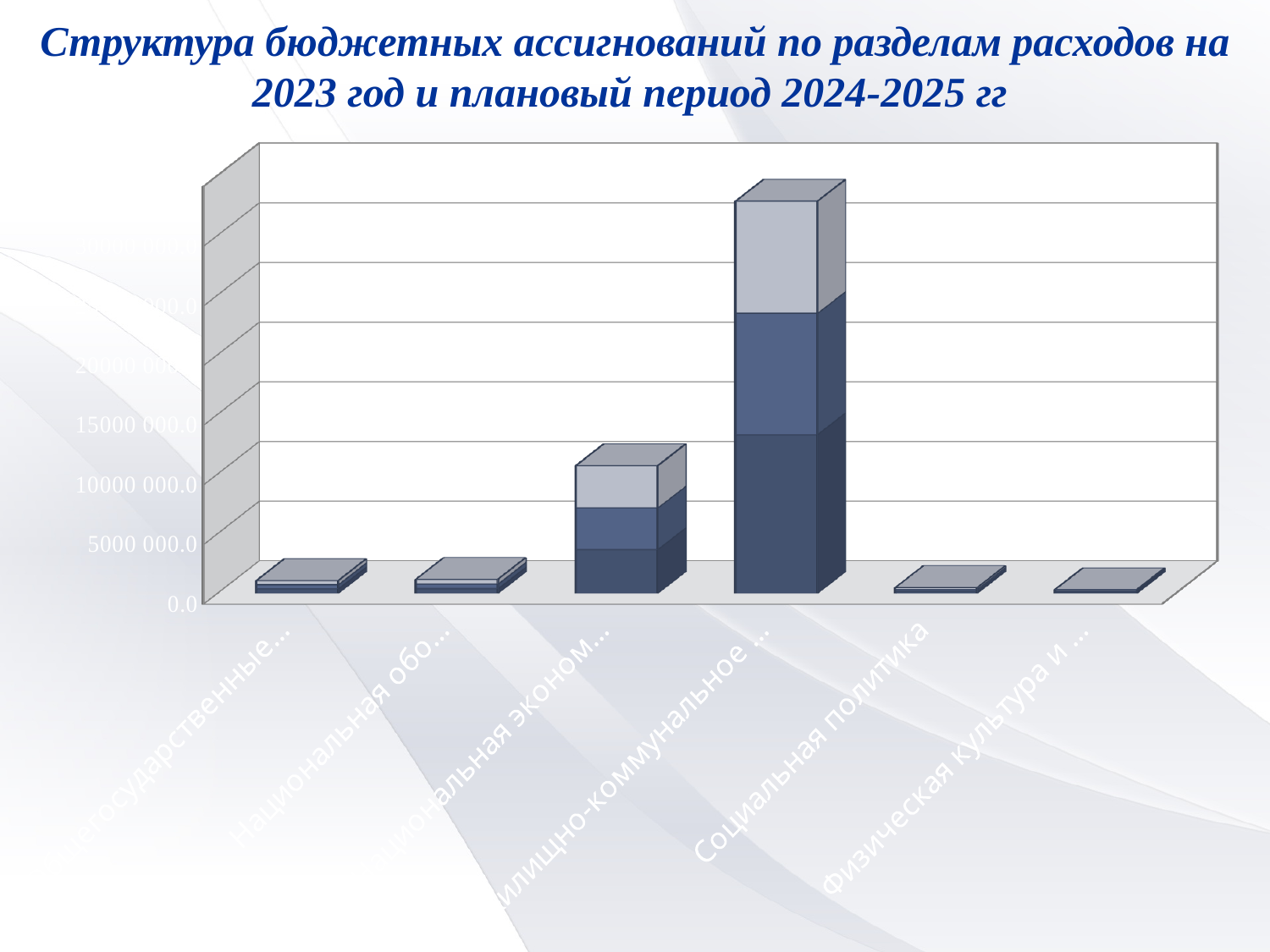
Is the total value for the Жилищно-коммунальное bar greater or less than 20000 000.0? greater How many stacked segments make up the tallest bar in the chart? 3 Is the total value for the Общегосударственные... bar greater or less than 5000 000.0? less What is the title of the slide containing the chart? Структура бюджетных ассигнований по разделам расходов на 2023 год и плановый период 2024-2025 гг Which bar is taller: Национальная эконом... or Общегосударственные...? Национальная эконом... What kind of chart is shown on the slide? Stacked bar chart Is the total value for the Национальная эконом... bar greater or less than 15000 000.0? less Which bar is taller: Жилищно-коммунальное or Национальная эконом...? Жилищно-коммунальное How many categories are shown along the x axis of the chart? 6 Which category has the tallest bar in the chart? Жилищно-коммунальное ...